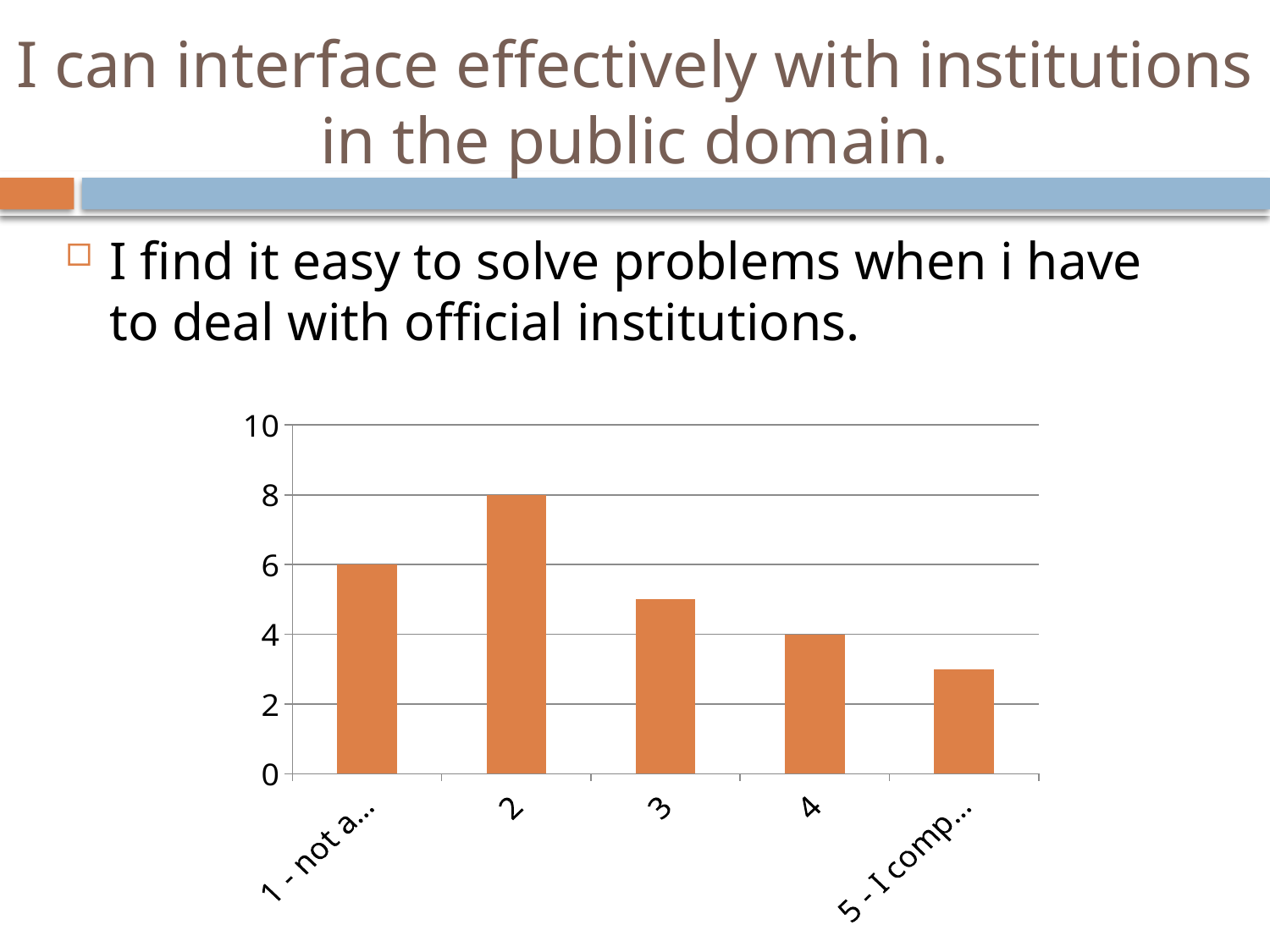
What is the value for the first category, "1 - not a..."? 6 What is the value for category 4? 4 What is the difference between the value for category 2 and the value for category 4? 4 Which category has the highest bar? 2 Which is larger, the value for category 3 or the value for category 4? 3 Is the value for category 3 greater or less than 4? greater What is the difference between the value for category 2 and the value for category "1 - not a..."? 2 How many categories are plotted on the x axis of the chart? 5 Which category has the lowest bar? 5 - I comp... Is the value for the last category, "5 - I comp...", greater or less than 4? less What is the value for category 2? 8 What type of chart is shown on the slide? bar chart